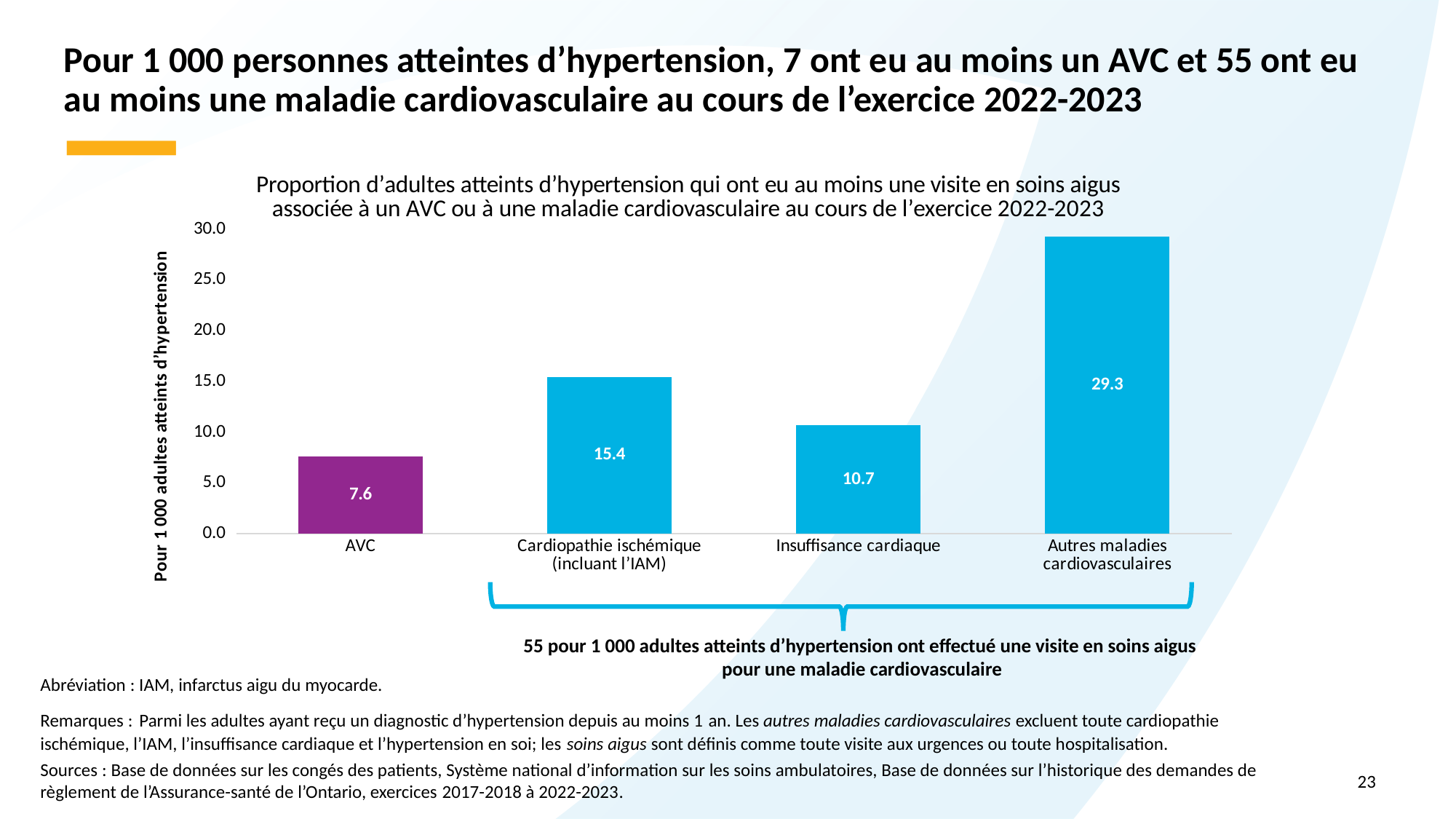
What is the label of the vertical axis? Pour 1 000 adultes atteints d'hypertension What is the difference between the values for Autres maladies cardiovasculaires and AVC? 21.7 What is the value for Insuffisance cardiaque? 10.7 How many categories are shown on the x axis? 4 What is the value for Cardiopathie ischémique (incluant l'IAM)? 15.4 Which category has the lowest value? AVC What is the value for AVC? 7.6 What kind of chart is shown on the slide? Bar chart Which is larger, the value for Cardiopathie ischémique (incluant l'IAM) or the value for Insuffisance cardiaque? Cardiopathie ischémique (incluant l'IAM) What is the value for Autres maladies cardiovasculaires? 29.3 What is the difference between the values for Cardiopathie ischémique (incluant l'IAM) and Insuffisance cardiaque? 4.7 Which category has the highest value? Autres maladies cardiovasculaires